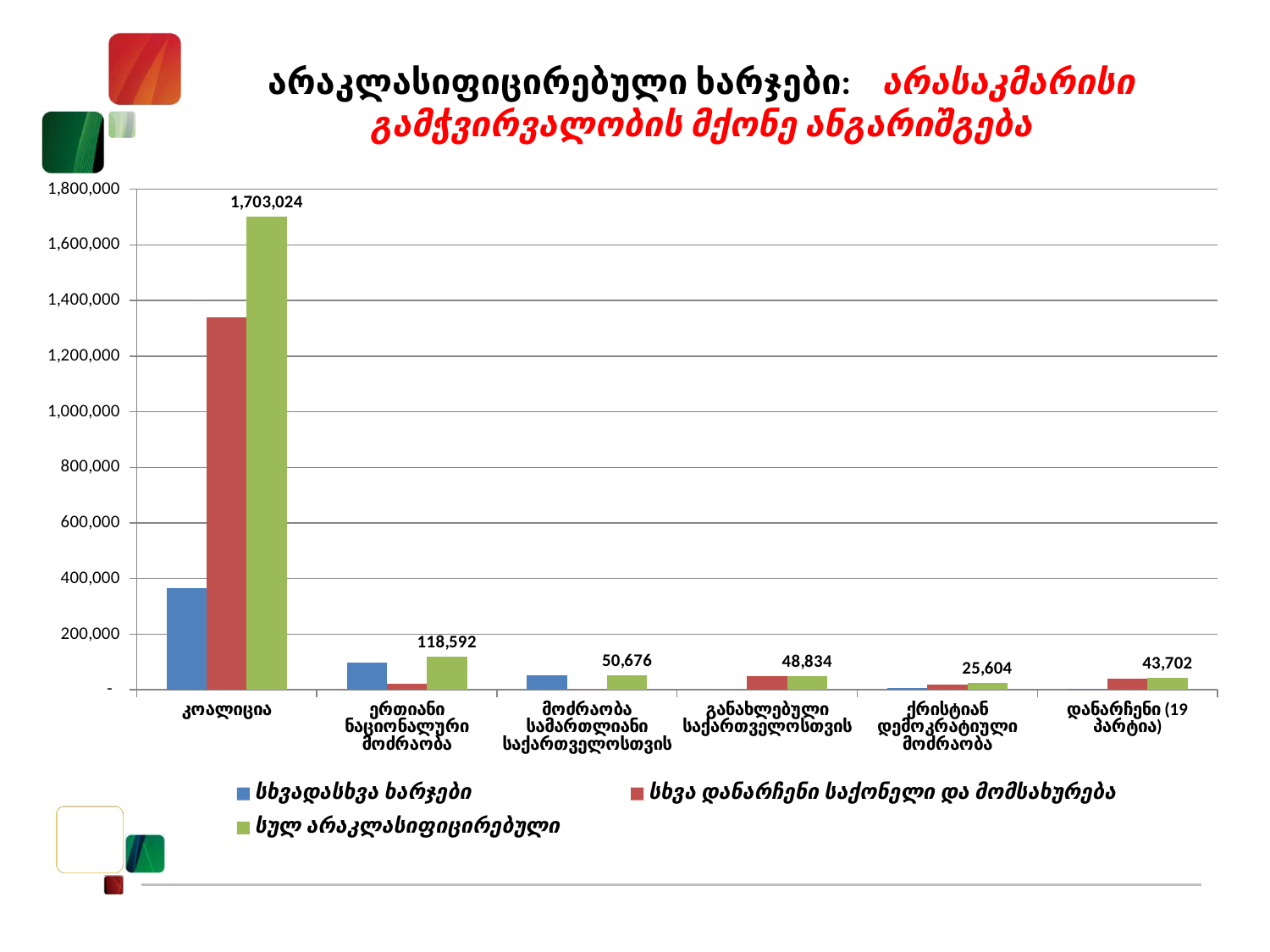
Is the value of სხვა დანარჩენი საქონელი და მომსახურება for კოალიცია greater or less than 1,200,000? greater Which category has the highest სულ არაკლასიფიცირებული value? კოალიცია Which is larger: the სულ არაკლასიფიცირებული value for დანარჩენი (19 პარტია) or for ქრისტიან დემოკრატიული მოძრაობა? დანარჩენი (19 პარტია) What is the value of სულ არაკლასიფიცირებული for კოალიცია? 1,703,024 What is the value of სულ არაკლასიფიცირებული for ერთიანი ნაციონალური მოძრაობა? 118,592 How many series does the legend list? 3 How many categories are shown on the x axis? 6 Is the value of სხვადასხვა ხარჯები for კოალიცია greater or less than 400,000? less What is the difference between the სულ არაკლასიფიცირებული values for მოძრაობა სამართლიანი საქართველოსთვის and განახლებული საქართველოსთვის? 1,842 What is the value of სულ არაკლასიფიცირებული for დანარჩენი (19 პარტია)? 43,702 Which category has the lowest სულ არაკლასიფიცირებული value? ქრისტიან დემოკრატიული მოძრაობა What is the value of სულ არაკლასიფიცირებული for ქრისტიან დემოკრატიული მოძრაობა? 25,604